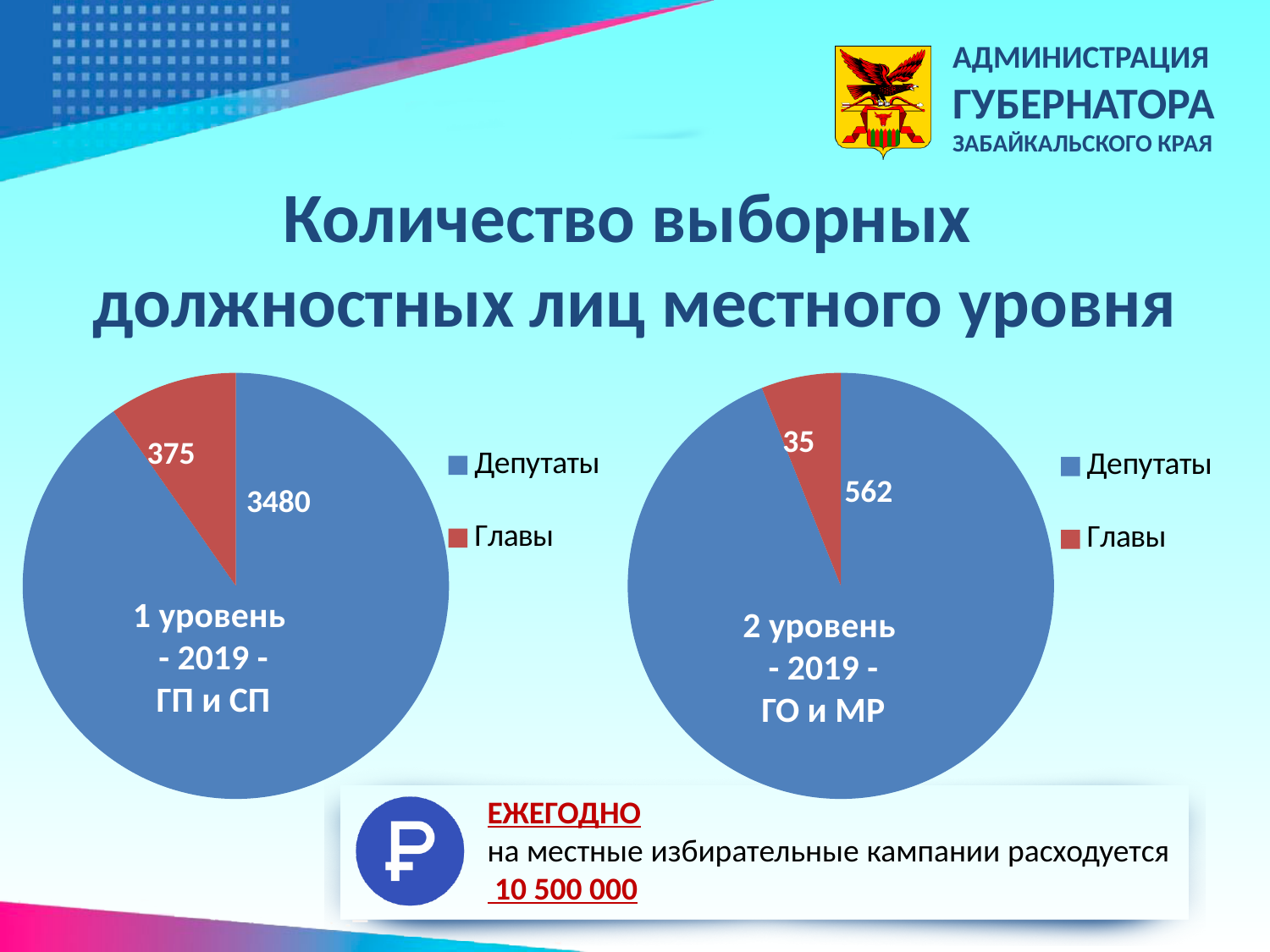
What type of chart is used on this slide? Pie chart In the right pie chart (2 уровень - 2019 - ГО и МР), which category has the smallest slice? Главы In the left pie chart (1 уровень - 2019 - ГП и СП), what is the value for Главы? 375 Which is larger: Главы in the left pie chart (1 уровень) or Главы in the right pie chart (2 уровень)? Главы in the left pie chart (1 уровень) How many series does the legend of the left pie chart (1 уровень - 2019 - ГП и СП) list? 2 In the left pie chart (1 уровень - 2019 - ГП и СП), what is the value for Депутаты? 3480 In the right pie chart (2 уровень - 2019 - ГО и МР), what is the value for Депутаты? 562 In the left pie chart (1 уровень - 2019 - ГП и СП), what is the difference between Депутаты and Главы? 3105 In the left pie chart (1 уровень - 2019 - ГП и СП), what is the total of Депутаты and Главы? 3855 In the right pie chart (2 уровень - 2019 - ГО и МР), what is the difference between Депутаты and Главы? 527 In the left pie chart (1 уровень - 2019 - ГП и СП), which category has the largest slice? Депутаты In the right pie chart (2 уровень - 2019 - ГО и МР), what is the value for Главы? 35